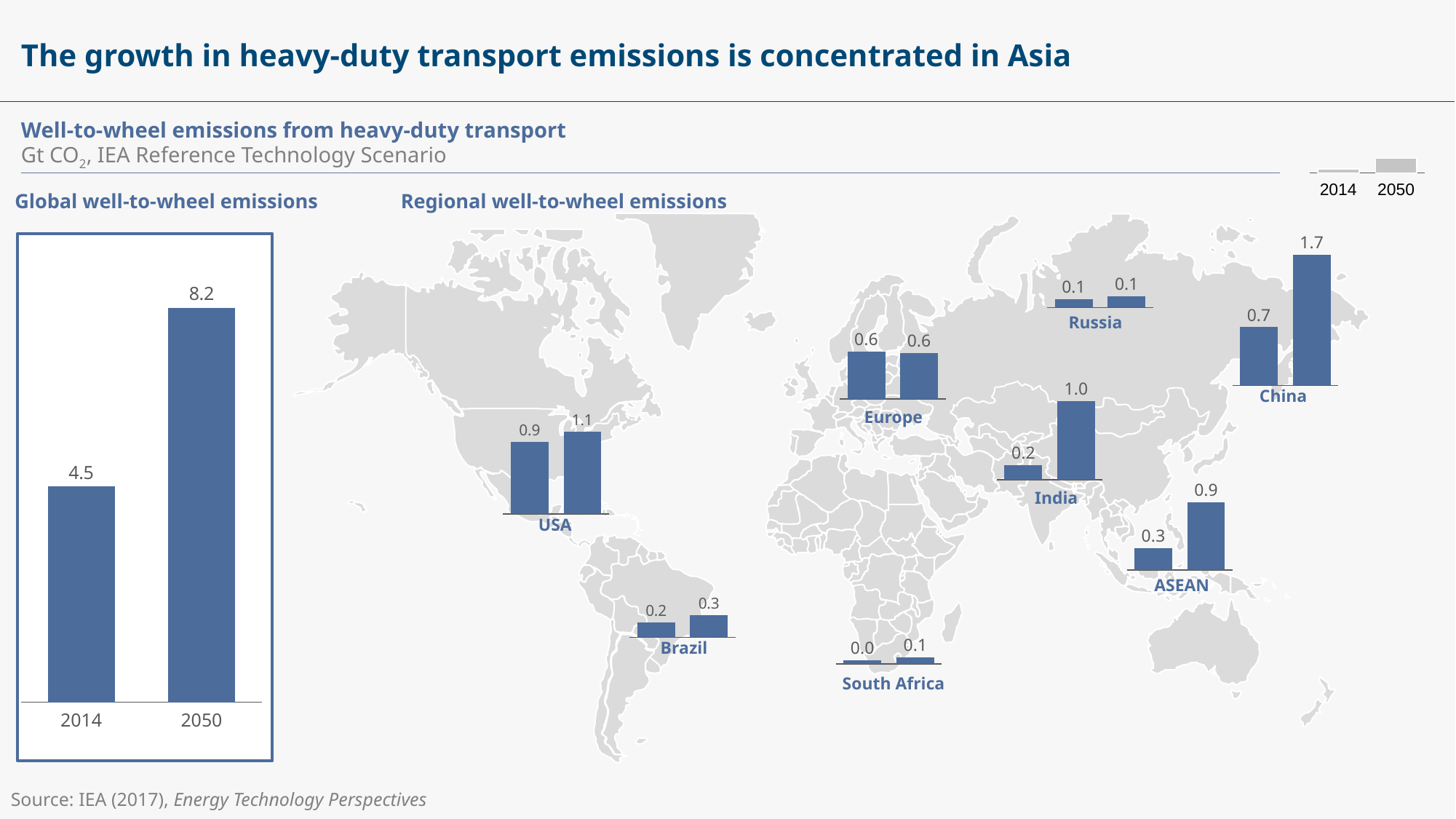
In the 'Regional well-to-wheel emissions' map, what is the 2050 value for China? 1.7 How many regions are shown in the 'Regional well-to-wheel emissions' map? 8 In the 'Regional well-to-wheel emissions' map, what is the difference between the 2050 and 2014 values for India? 0.8 What kind of chart is the 'Global well-to-wheel emissions' chart? bar chart In the 'Global well-to-wheel emissions' chart, what is the value for 2050? 8.2 In the 'Regional well-to-wheel emissions' map, what is the 2014 value for India? 0.2 In the 'Regional well-to-wheel emissions' map, which is larger: the 2050 value for USA or the 2050 value for ASEAN? USA In the 'Global well-to-wheel emissions' chart, what is the difference between the 2050 and 2014 values? 3.7 In the 'Regional well-to-wheel emissions' map, which region has the lowest 2014 value? South Africa In the 'Global well-to-wheel emissions' chart, what is the value for 2014? 4.5 How many series does the legend at the top right of the slide list? 2 In the 'Regional well-to-wheel emissions' map, which region has the highest 2050 value? China